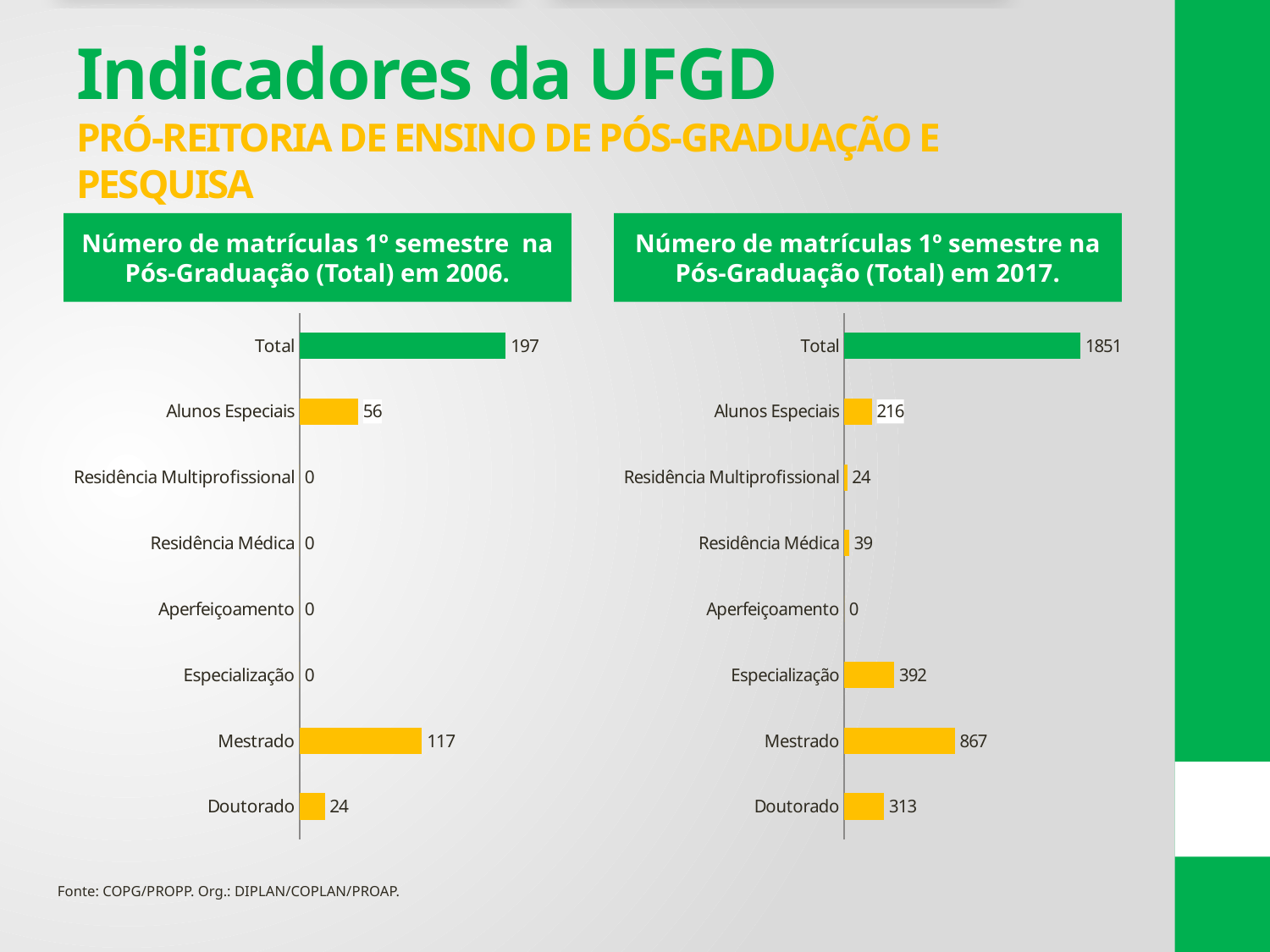
In the 2006 chart (left), how many categories have a value of 0? 4 What is the title of the chart on the left? Número de matrículas 1º semestre na Pós-Graduação (Total) em 2006. In the 2017 chart (right), which is larger, Alunos Especiais or Doutorado? Doutorado In the 2017 chart (right), what is the difference between Mestrado and Doutorado? 554 In the 2006 chart (left), what is the value for Mestrado? 117 In the 2006 chart (left), what is the difference between Alunos Especiais and Doutorado? 32 In the 2017 chart (right), what is the value for Especialização? 392 In the 2017 chart (right), which category has the lowest value? Aperfeiçoamento What kind of chart is the 2017 chart (right)? Bar chart In the 2006 chart (left), which category other than Total has the highest value? Mestrado How many categories are shown in the 2006 chart (left)? 8 In the 2017 chart (right), what is the value for Total? 1851